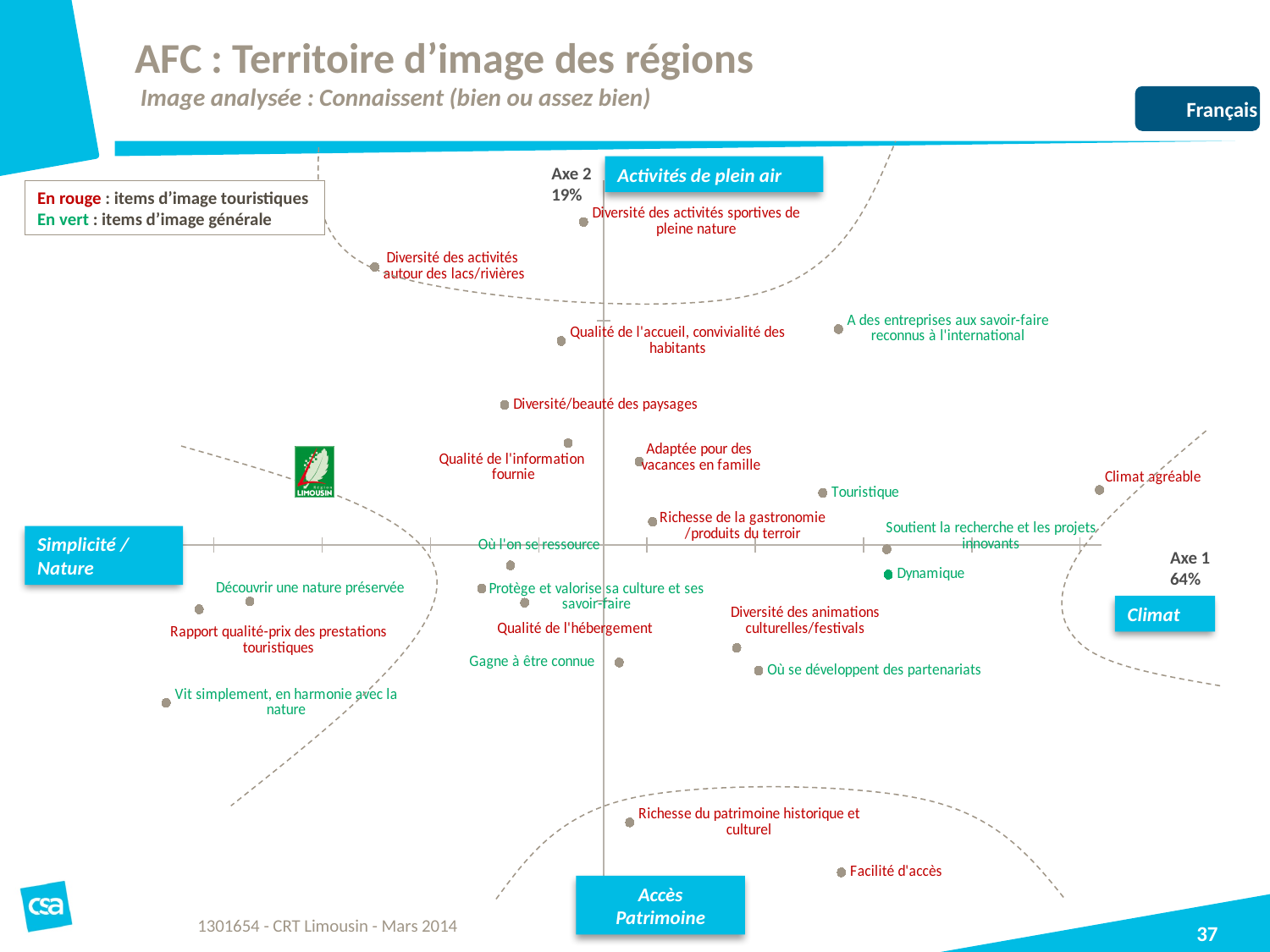
What percentage is shown for Axe 2? 19% Which item is plotted furthest to the right on Axe 1? Climat agréable What percentage is shown for Axe 1? 64% What label is shown at the left end of Axe 1? Simplicité / Nature Is the point for "Facilité d'accès" plotted above or below the point for "Richesse du patrimoine historique et culturel"? below Which is plotted higher on Axe 2: "Qualité de l'accueil, convivialité des habitants" or "Diversité/beauté des paysages"? Qualité de l'accueil, convivialité des habitants Is the point for "Dynamique" plotted to the right or to the left of the point for "Touristique"? right Which item is plotted lowest on Axe 2? Facilité d'accès Which item is plotted furthest to the left on Axe 1? Vit simplement, en harmonie avec la nature What kind of chart is shown on the slide? scatter chart Which item is plotted highest on Axe 2? Diversité des activités sportives de pleine nature According to the legend, what do the items written in red represent? items d'image touristiques